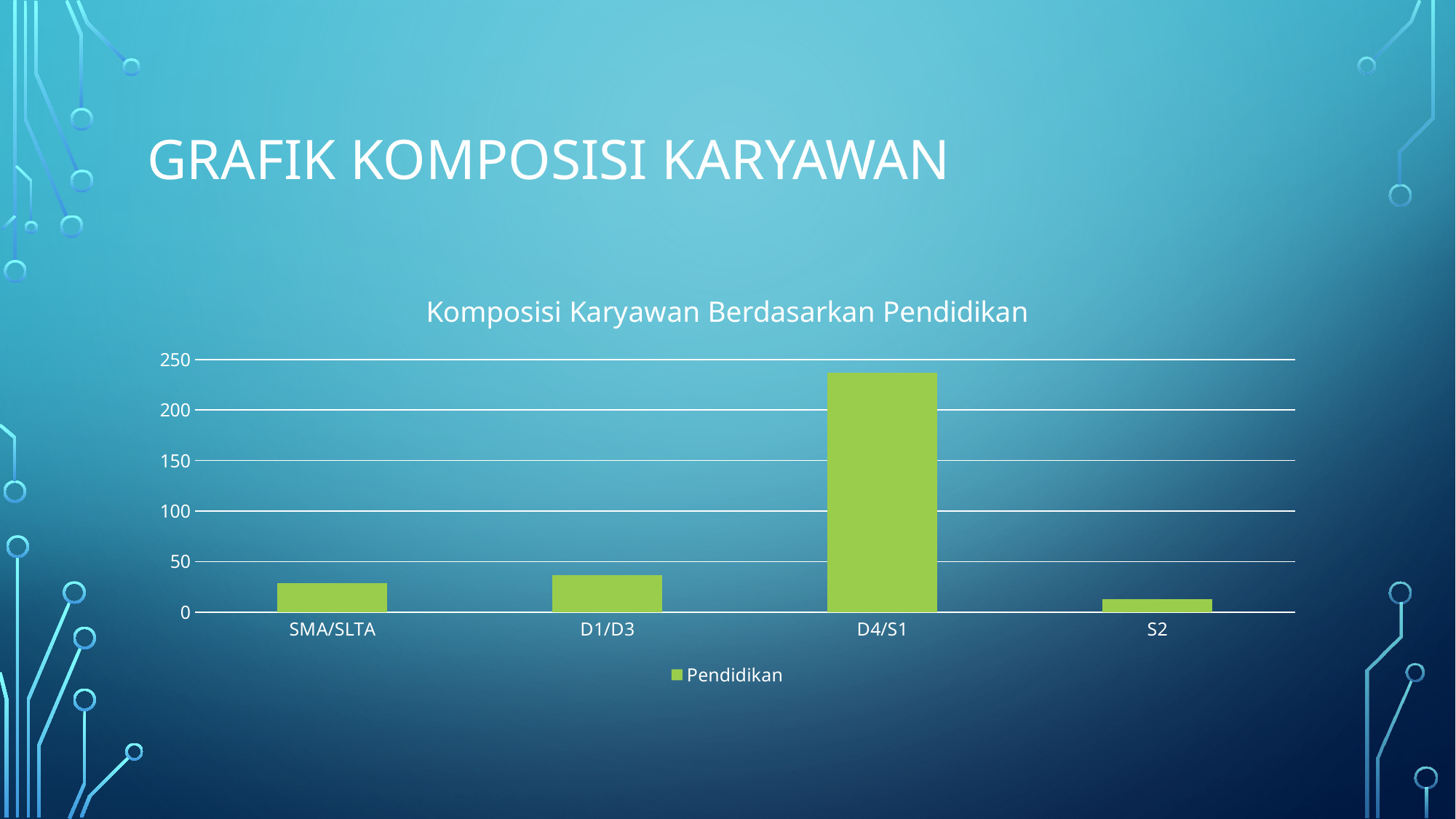
Is the value for SMA/SLTA greater or less than 50? less What series name appears in the legend? Pendidikan Which is larger, the value for D4/S1 or the value for S2? D4/S1 How many series does the legend list? 1 How many education categories are shown on the x axis? 4 What is the title of the chart? Komposisi Karyawan Berdasarkan Pendidikan Is the value for S2 greater or less than 50? less Is the value for D4/S1 greater or less than 200? greater Which is larger, the value for D1/D3 or the value for S2? D1/D3 Which education category has the lowest value? S2 What kind of chart is shown on the slide? bar chart Which education category has the highest value? D4/S1